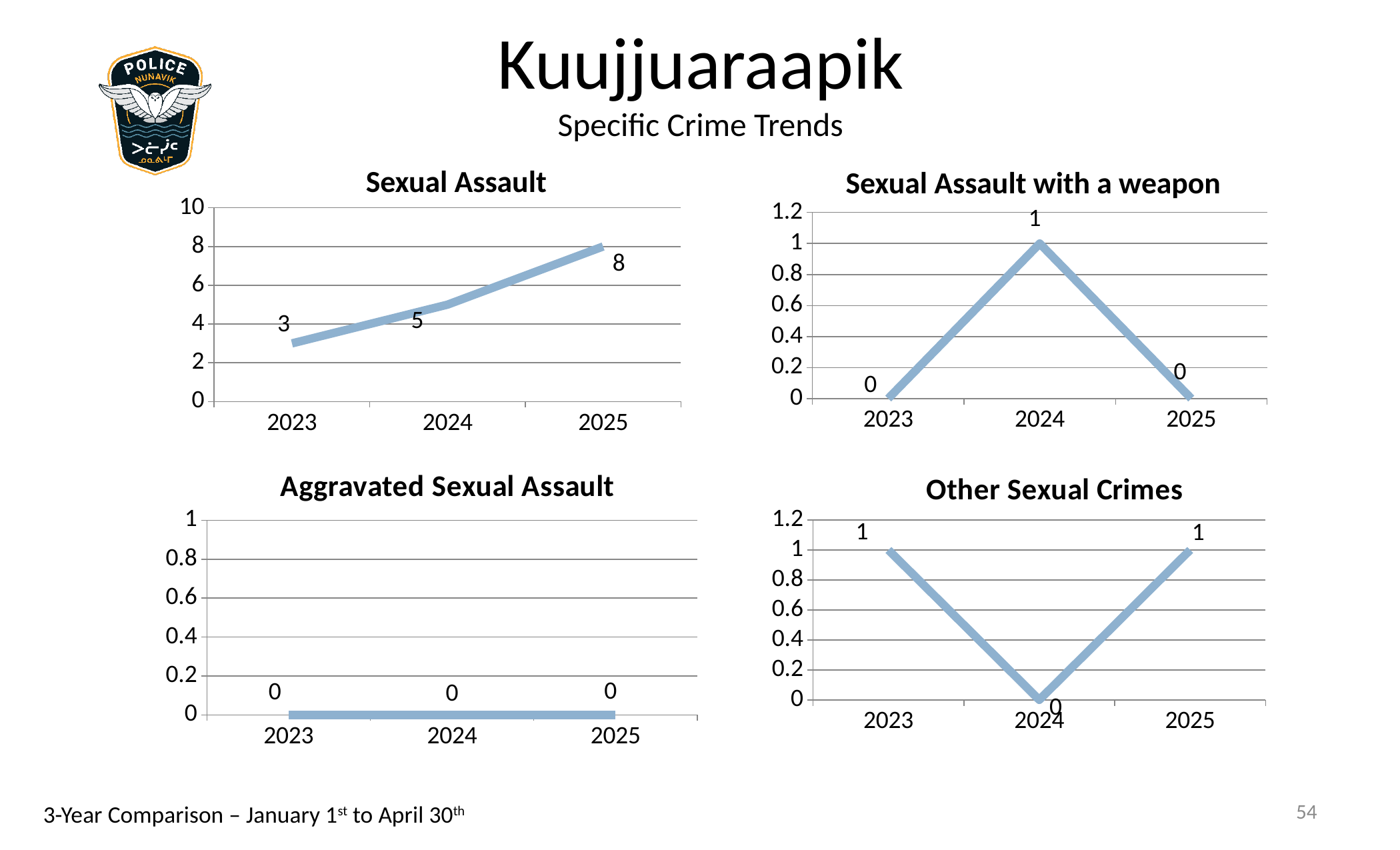
In the Sexual Assault chart, what is the value for 2025? 8 In the Sexual Assault chart, which year has the highest value? 2025 In the Sexual Assault chart, do the values rise or fall from 2023 to 2025? rise In the Aggravated Sexual Assault chart, what is the value for 2025? 0 In the Sexual Assault chart, what is the value for 2023? 3 In the Other Sexual Crimes chart, which year has the lowest value? 2024 In the Other Sexual Crimes chart, is the value for 2023 larger or smaller than the value for 2024? larger What kind of chart is the Sexual Assault chart? line chart In the Sexual Assault with a weapon chart, which year has the highest value? 2024 In the Sexual Assault chart, what is the difference between the 2025 and 2023 values? 5 In the Aggravated Sexual Assault chart, how many years are plotted? 3 In the Sexual Assault with a weapon chart, what is the value for 2024? 1